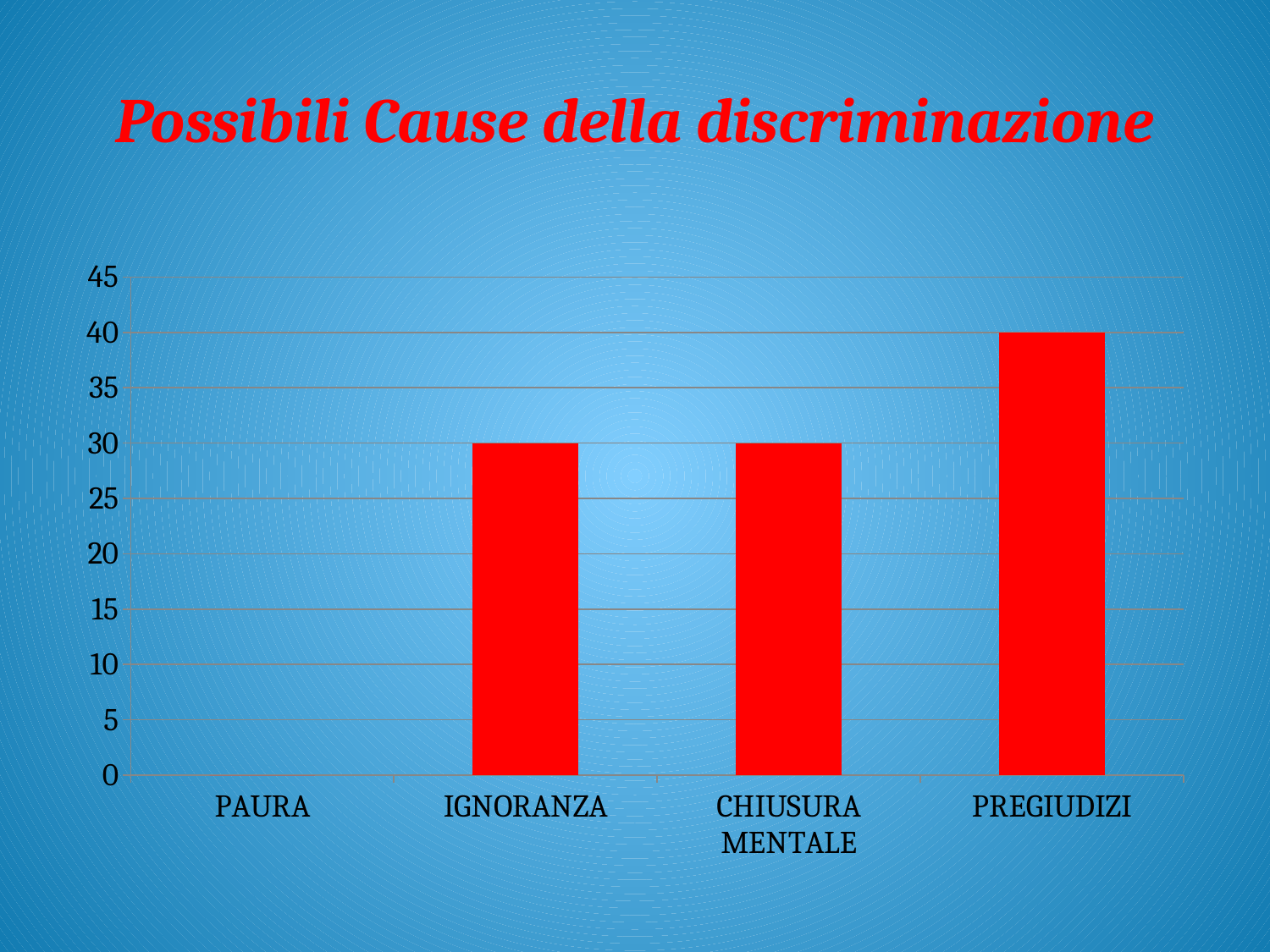
What is the value for IGNORANZA? 30 How many categories are shown on the x axis of the chart? 4 Is the value for PREGIUDIZI greater or less than 35? greater What colour are the bars in the chart? red Which is larger, the value for PREGIUDIZI or the value for CHIUSURA MENTALE? PREGIUDIZI What is the value for CHIUSURA MENTALE? 30 What is the value for PREGIUDIZI? 40 What is the difference between the values for PREGIUDIZI and IGNORANZA? 10 What is the title of the slide? Possibili Cause della discriminazione Which category has the highest value? PREGIUDIZI What kind of chart is shown on the slide? bar chart Is the value for IGNORANZA greater or less than 25? greater